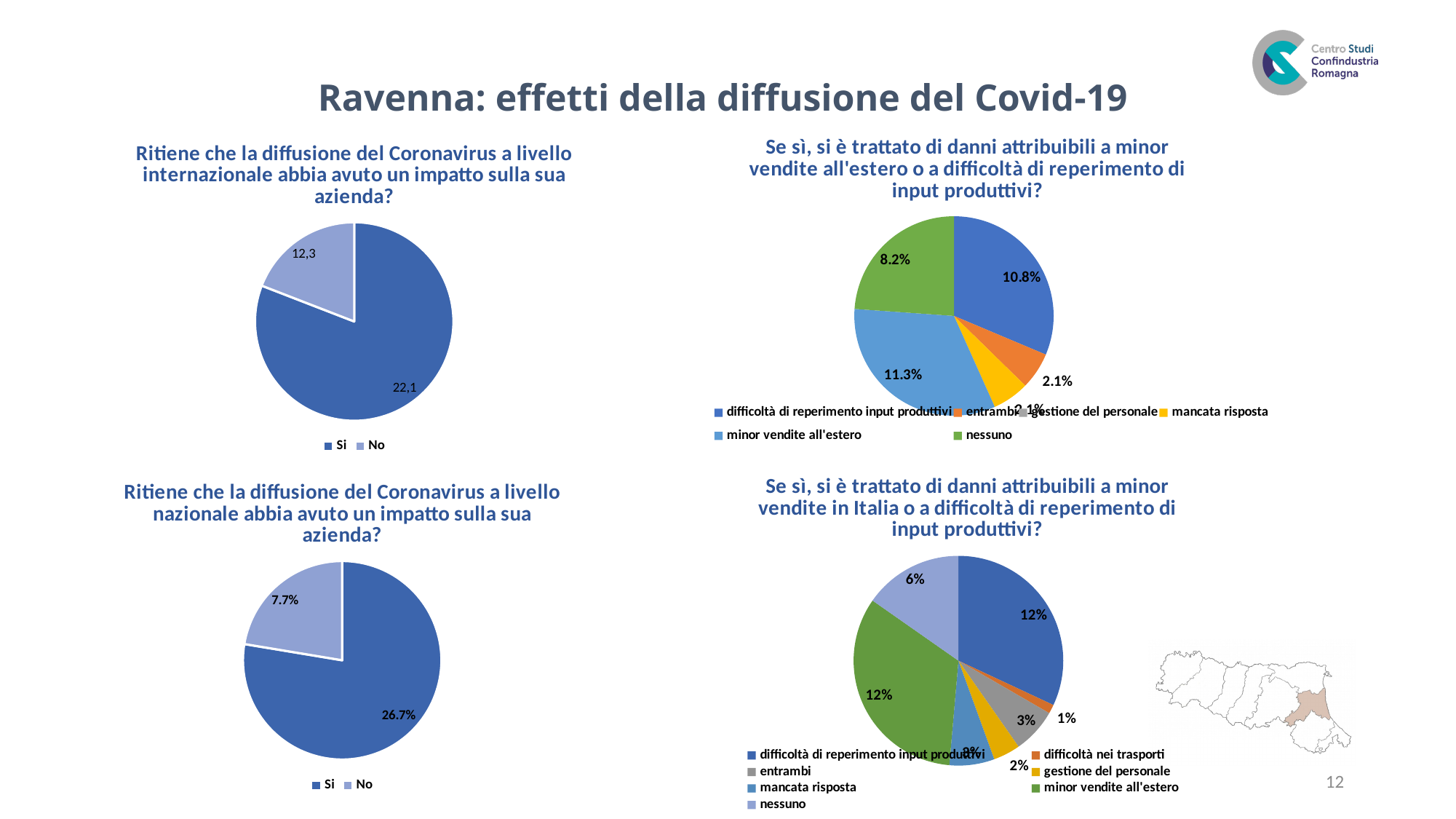
What type of chart is used for the bottom-left chart about the national spread of the Coronavirus? Pie chart In the bottom-right pie chart (minor vendite in Italia), what is the value for "nessuno"? 6% In the top-right pie chart (minor vendite all'estero), what is the value for "minor vendite all'estero"? 11.3% In the bottom-left pie chart about the national spread of the Coronavirus, which category is larger, "Si" or "No"? Si In the bottom-right pie chart (minor vendite in Italia), which category has the smallest value? difficoltà nei trasporti In the bottom-left pie chart about the national spread of the Coronavirus, what is the value for "No"? 7.7% In the bottom-left pie chart about the national spread of the Coronavirus, what is the value for "Si"? 26.7% In the top-left pie chart about the international spread of the Coronavirus, what is the value for "No"? 12,3 In the top-right pie chart (minor vendite all'estero), how many entries does the legend list? 6 In the top-right pie chart (minor vendite all'estero), what is the value for "nessuno"? 8.2% In the top-left pie chart about the international spread of the Coronavirus, what is the value for "Si"? 22,1 In the top-right pie chart (minor vendite all'estero), what is the value for "difficoltà di reperimento input produttivi"? 10.8%